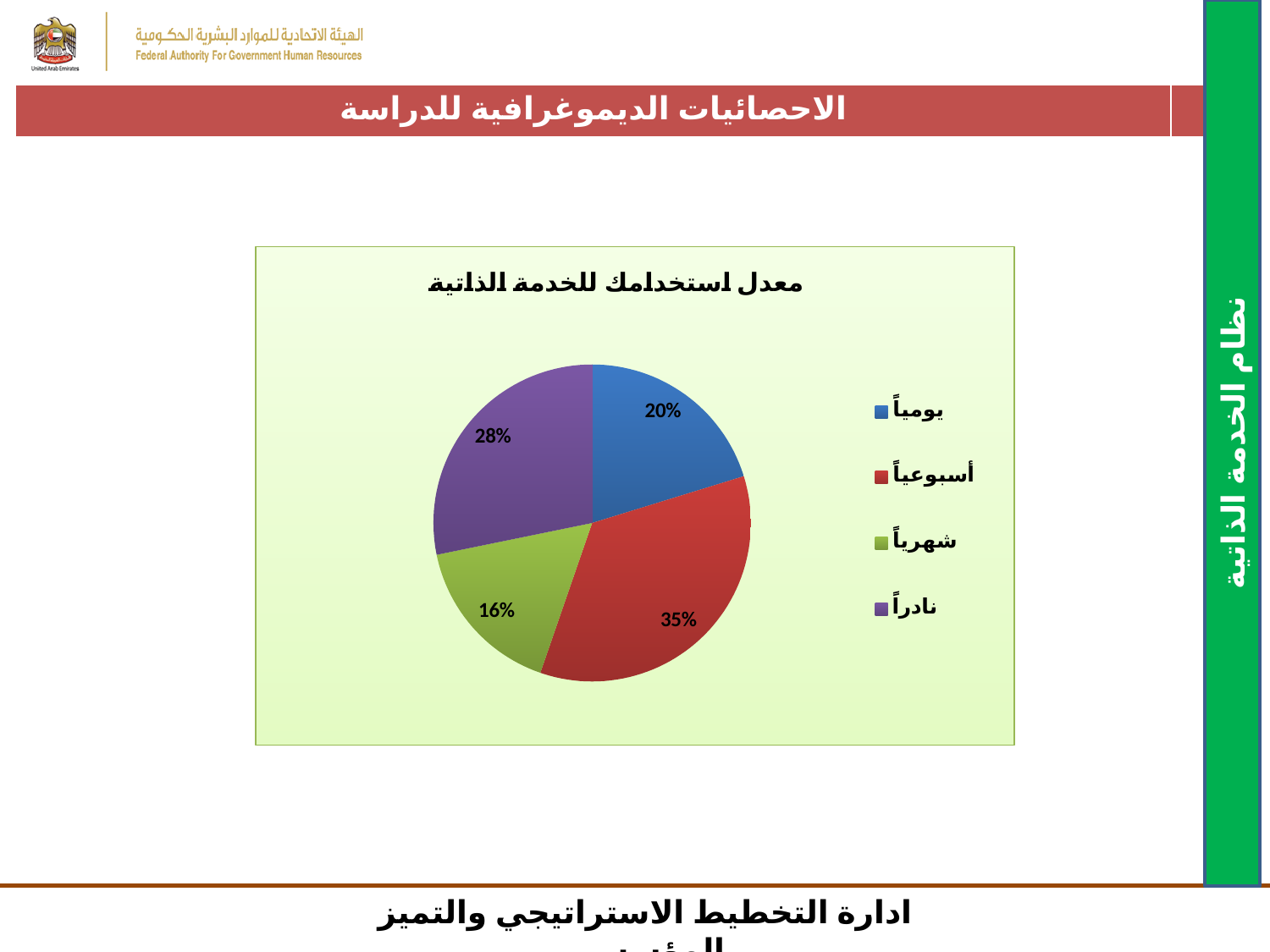
What is the difference between the shares for أسبوعياً and شهرياً? 19% How many categories does the legend list? 4 What colour is the slice for نادراً? Purple What percentage of the pie is labelled for أسبوعياً? 35% Which category has the largest share of the pie? أسبوعياً Which category has the smallest share of the pie? شهرياً What type of chart is shown on the slide? Pie chart Which is larger, the share for نادراً or the share for يومياً? نادراً What percentage of the pie is labelled for نادراً? 28% What percentage of the pie is labelled for يومياً? 20% What percentage of the pie is labelled for شهرياً? 16% What is the title of the chart? معدل استخدامك للخدمة الذاتية